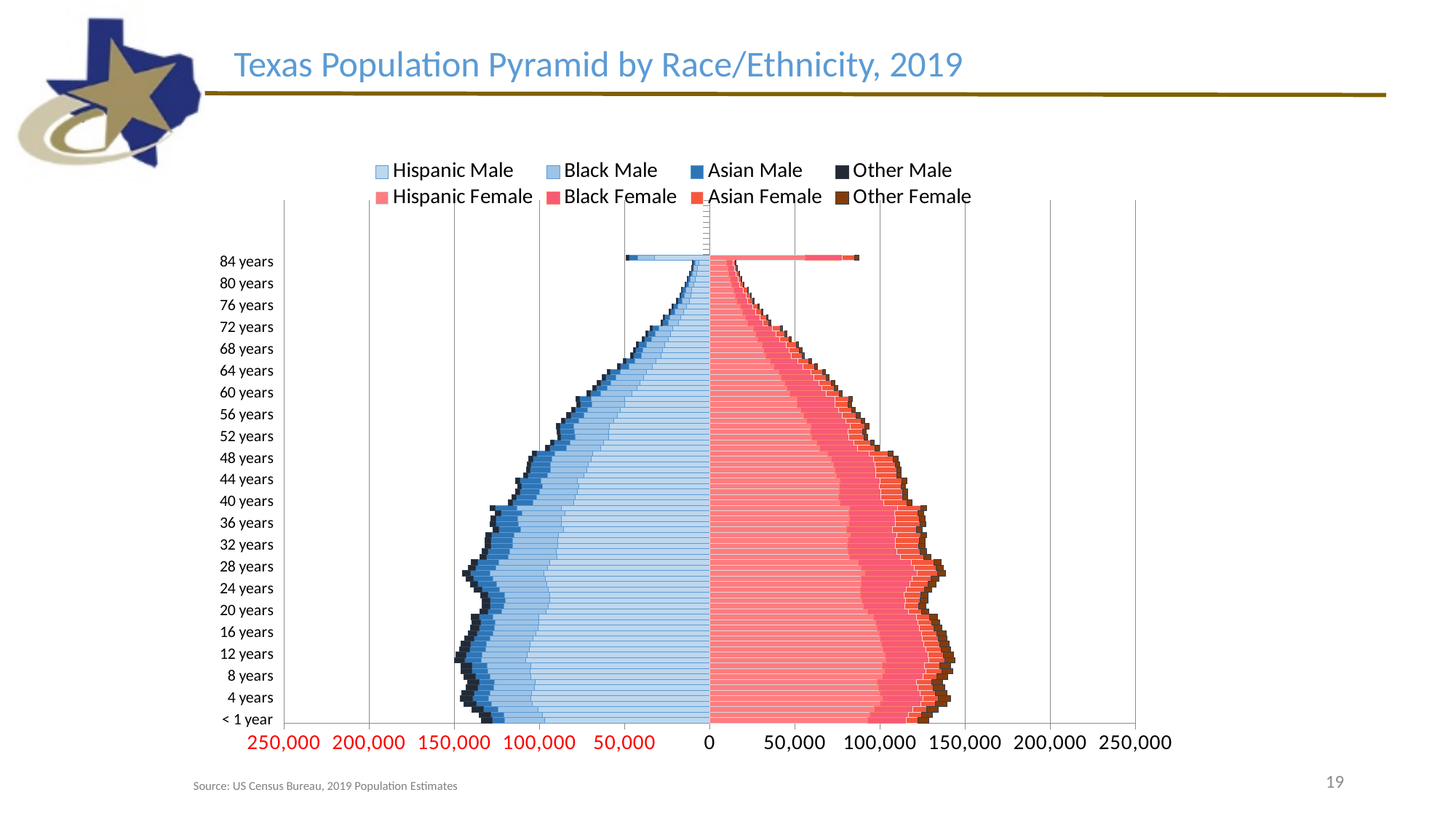
From 40 years upward, do the total bar lengths rise or fall as age increases? Fall Is the total male bar for 84 years greater or less than 100,000? less What is the title of the chart on the slide? Texas Population Pyramid by Race/Ethnicity, 2019 Is the total male bar for 28 years greater or less than 100,000? greater Which is larger on the male side, the total bar for 28 years or the total bar for 68 years? 28 years What kind of chart is shown on the slide? Bar chart (population pyramid) How many series does the legend list? 8 Which is larger at 84 years, the total male bar or the total female bar? Female Is the total female bar for 12 years greater or less than 200,000? less On which side of the central axis are the male bars plotted? Left